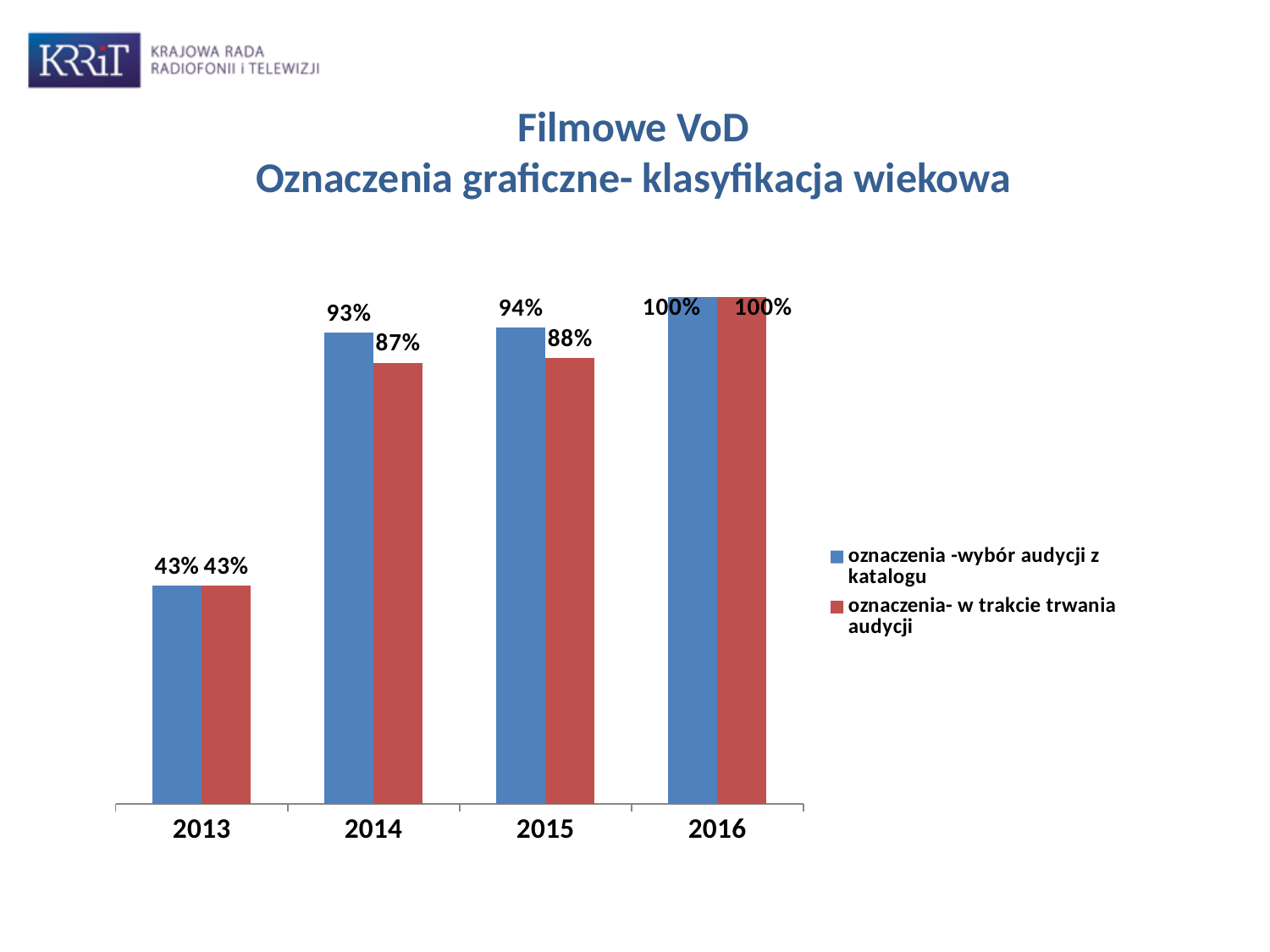
What is the value for 'oznaczenia -wybór audycji z katalogu' in 2013? 43% What is the value for 'oznaczenia -wybór audycji z katalogu' in 2014? 93% Do the values for 'oznaczenia- w trakcie trwania audycji' rise or fall from 2013 to 2016? rise Which year has the lowest value for 'oznaczenia- w trakcie trwania audycji'? 2013 In 2015, which series has the larger value: 'oznaczenia -wybór audycji z katalogu' or 'oznaczenia- w trakcie trwania audycji'? oznaczenia -wybór audycji z katalogu What kind of chart is shown on the slide? bar chart What is the value for 'oznaczenia- w trakcie trwania audycji' in 2015? 88% What is the difference between the two series in 2014? 6% How many years are shown on the x axis? 4 What is the difference between the 'oznaczenia -wybór audycji z katalogu' values for 2014 and 2013? 50% Which year has the highest value for 'oznaczenia -wybór audycji z katalogu'? 2016 How many series does the legend list? 2